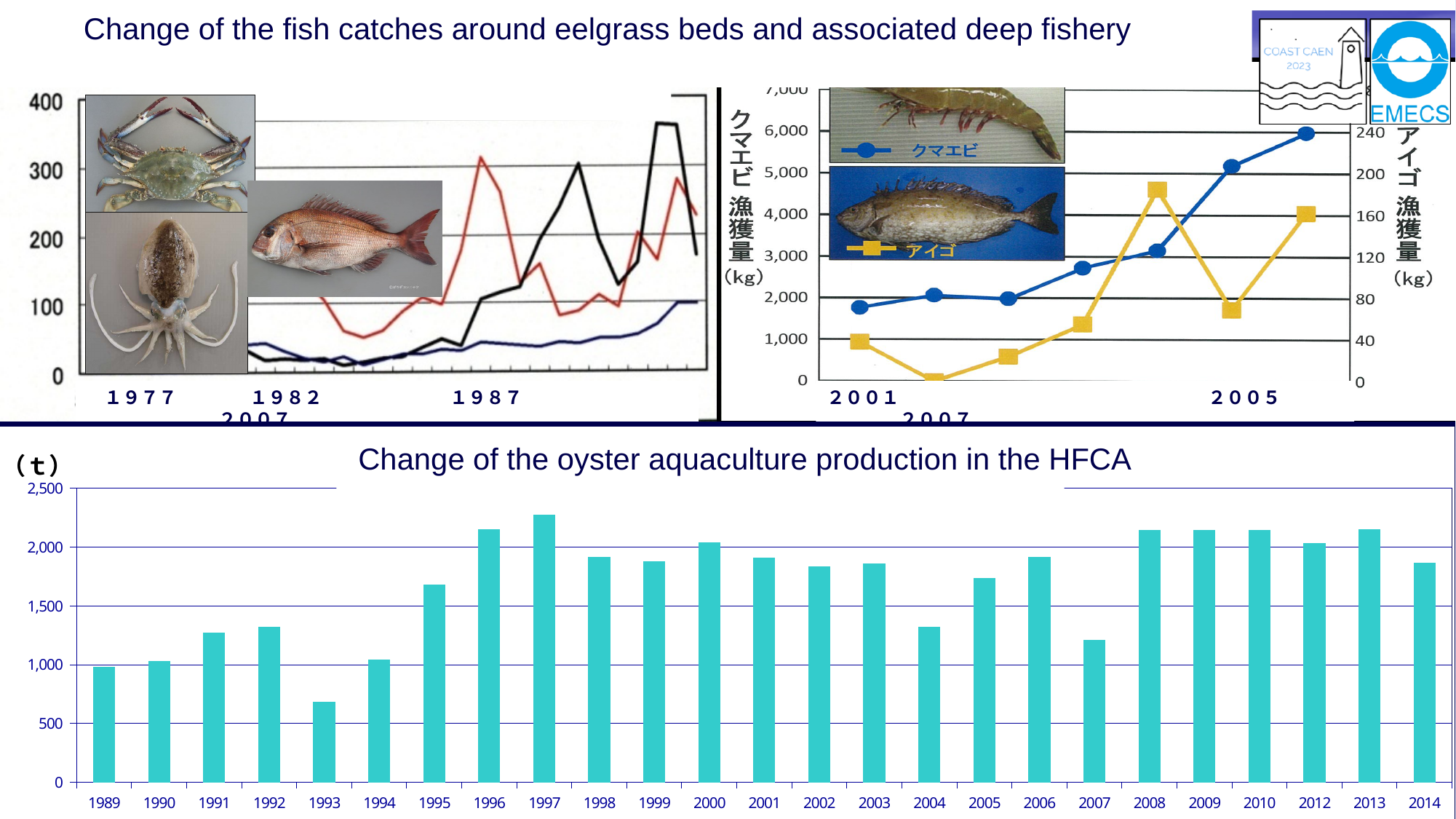
What kind of chart is the 'Change of the oyster aquaculture production in the HFCA' chart? bar chart In the 'Change of the oyster aquaculture production in the HFCA' chart, is the value for 1997 greater or less than 2,000? greater In the 'Change of the oyster aquaculture production in the HFCA' chart, is the value for 2007 greater or less than 1,500? less In the top-right line chart, does the クマエビ series generally rise or fall from 2001 to 2007? rise In the 'Change of the oyster aquaculture production in the HFCA' chart, which year has the highest production? 1997 How many series does the legend list in the top-right line chart (クマエビ / アイゴ)? 2 In the 'Change of the oyster aquaculture production in the HFCA' chart, what unit is shown on the y axis? (t) In the 'Change of the oyster aquaculture production in the HFCA' chart, which year has the larger value, 2004 or 2005? 2005 In the top-right line chart, is the クマエビ value for 2001 greater or less than 2,000? less In the 'Change of the oyster aquaculture production in the HFCA' chart, which year has the lowest production? 1993 How many years (bars) are shown in the 'Change of the oyster aquaculture production in the HFCA' chart? 25